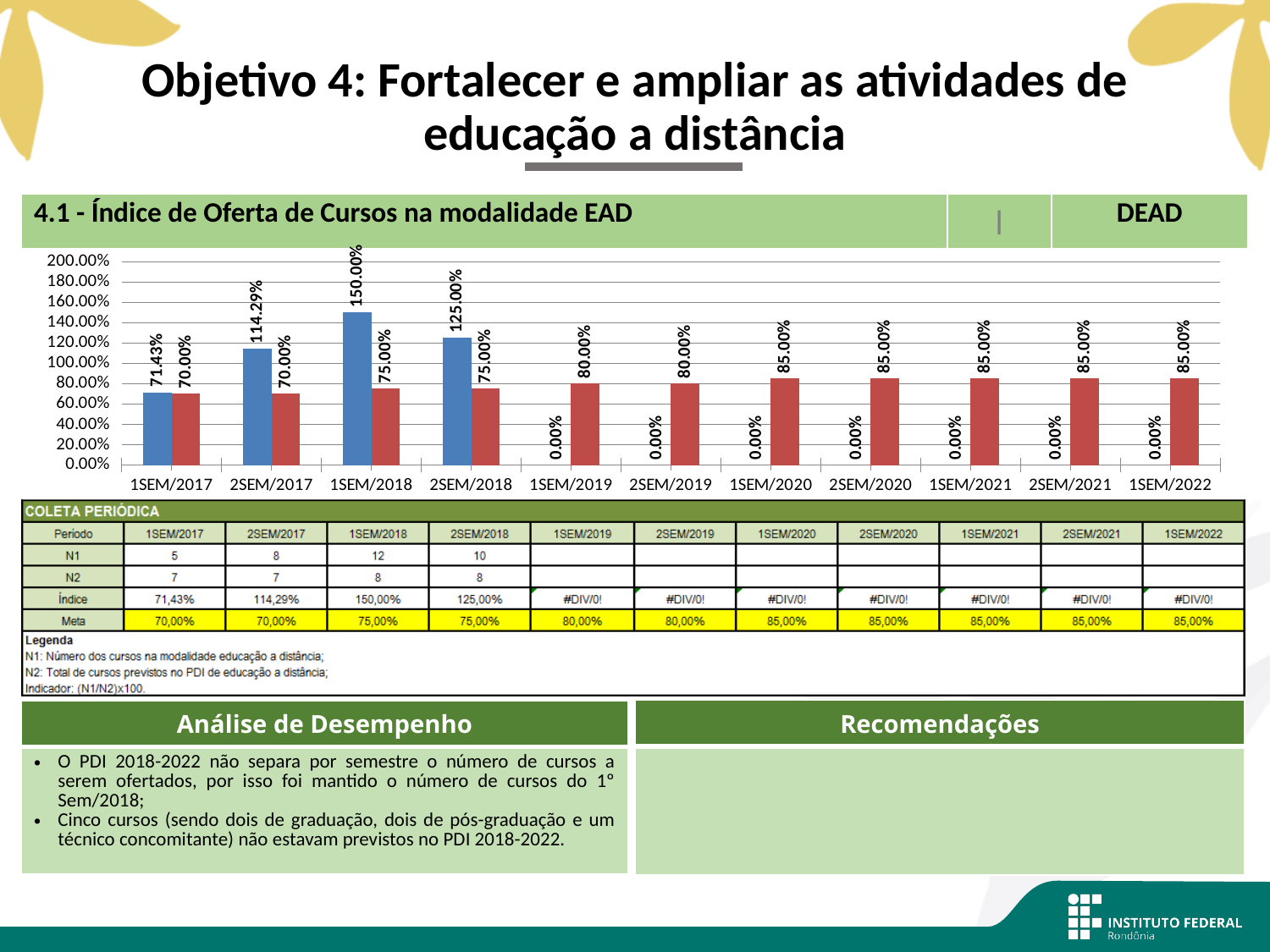
What type of chart is shown on the slide? bar chart Which period has the lowest red bar value among 1SEM/2017 and 2SEM/2017 compared with 1SEM/2018? 1SEM/2017 and 2SEM/2017 (70.00%) What is the value of the blue bar for 2SEM/2017? 114.29% What is the value of the blue bar for 1SEM/2018? 150.00% What is the value of the red bar for 1SEM/2022? 85.00% Which is larger for 1SEM/2017, the blue bar or the red bar? the blue bar Which period has the highest blue bar? 1SEM/2018 How many periods are shown on the x axis of the chart? 11 What is the value of the blue bar for 1SEM/2019? 0.00% Is the blue bar for 2SEM/2017 greater or less than 100.00%? greater What is the difference between the blue bar and the red bar for 2SEM/2018? 50.00% Do the red bar values rise or fall from 1SEM/2017 to 1SEM/2022? rise